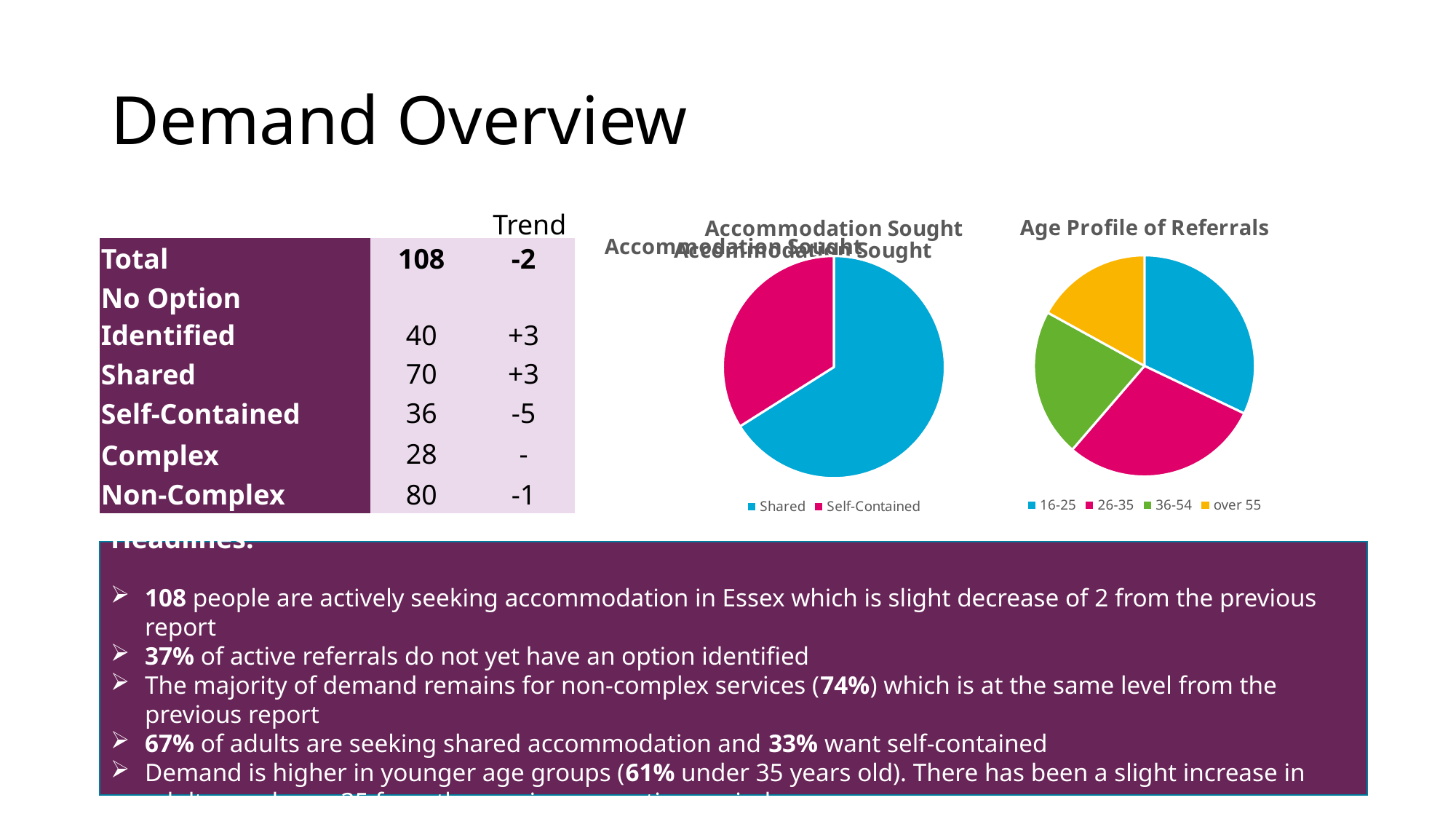
What kind of chart is the Age Profile of Referrals chart? pie chart What is the title of the pie chart on the right of the slide? Age Profile of Referrals How many slices does the Accommodation Sought pie chart have? 2 In the Accommodation Sought chart, which slice is larger: Shared or Self-Contained? Shared In the Age Profile of Referrals chart, which slice is larger: 16-25 or over 55? 16-25 In the Age Profile of Referrals chart, which slice is larger: 36-54 or over 55? 36-54 In the Accommodation Sought chart, which category has the largest slice? Shared In the Age Profile of Referrals chart, which age group has the smallest slice? over 55 What kind of chart is the Accommodation Sought chart? pie chart In the Accommodation Sought chart, which category has the smallest slice? Self-Contained How many categories does the legend of the Age Profile of Referrals chart list? 4 In the Age Profile of Referrals chart, what colour is the 36-54 slice? green